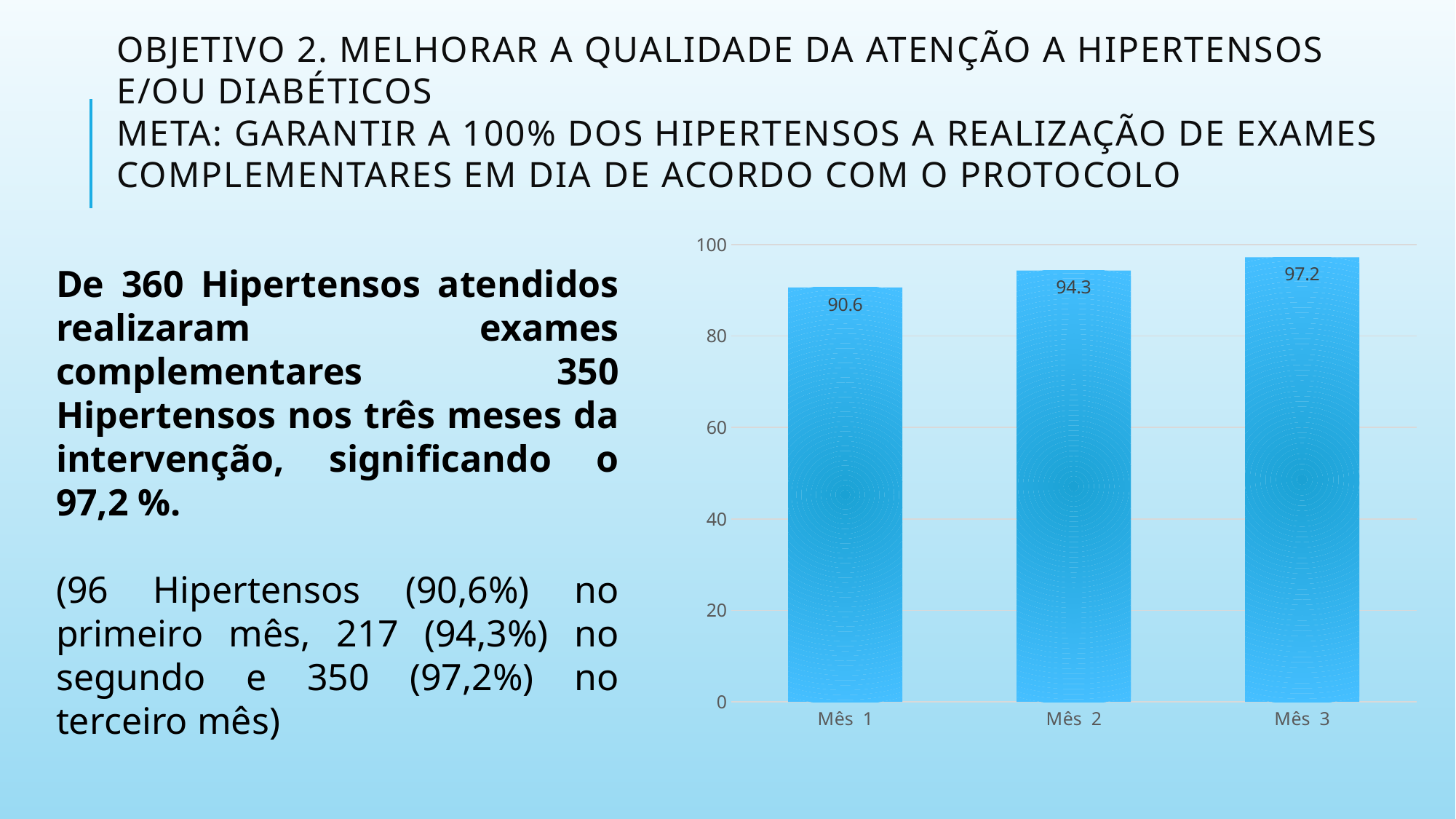
What is the value for Mês 1? 90.6 Do the values rise or fall from Mês 1 to Mês 3? rise How many categories are shown on the x axis? 3 What is the value for Mês 2? 94.3 Is the value for Mês 1 greater or less than 80? greater What kind of chart is shown on the slide? bar chart Which month has the lowest value? Mês 1 What is the difference between the values for Mês 3 and Mês 1? 6.6 What is the difference between the values for Mês 2 and Mês 1? 3.7 What is the value for Mês 3? 97.2 Which is larger, the value for Mês 2 or the value for Mês 3? Mês 3 Which month has the highest value? Mês 3